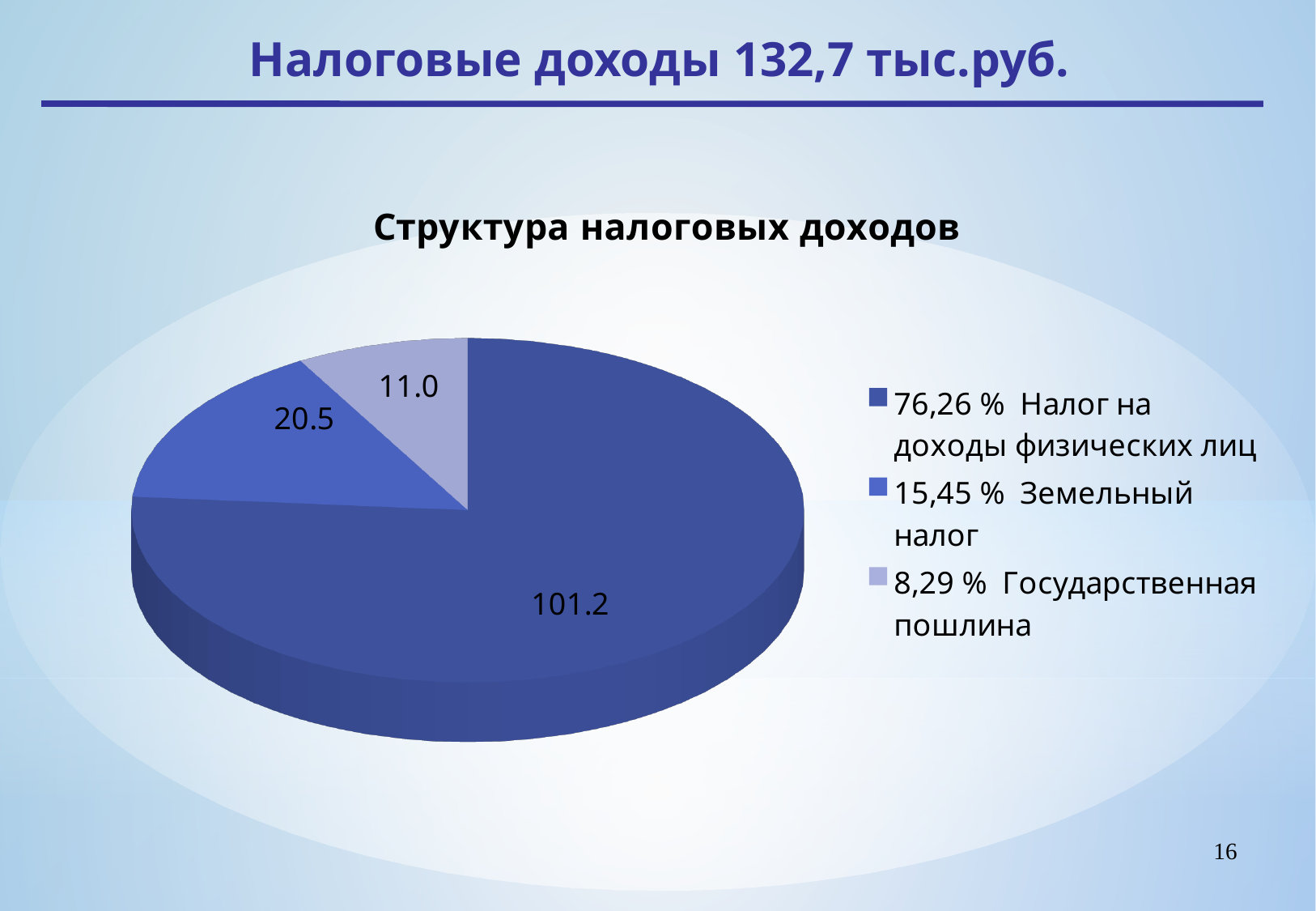
How many slices does the pie chart have? 3 What is the value shown for Налог на доходы физических лиц? 101.2 What is the value shown for Земельный налог? 20.5 What share of the pie does Налог на доходы физических лиц represent, according to the legend? 76,26 % What kind of chart is shown on the slide? Pie chart What is the title of the chart? Структура налоговых доходов What is the value shown for Государственная пошлина? 11.0 What share of the pie does Земельный налог represent, according to the legend? 15,45 % Which category has the smallest slice of the pie? Государственная пошлина What is the difference between the values for Земельный налог and Государственная пошлина? 9.5 Which is larger, the value for Земельный налог or the value for Государственная пошлина? Земельный налог Which category has the largest slice of the pie? Налог на доходы физических лиц